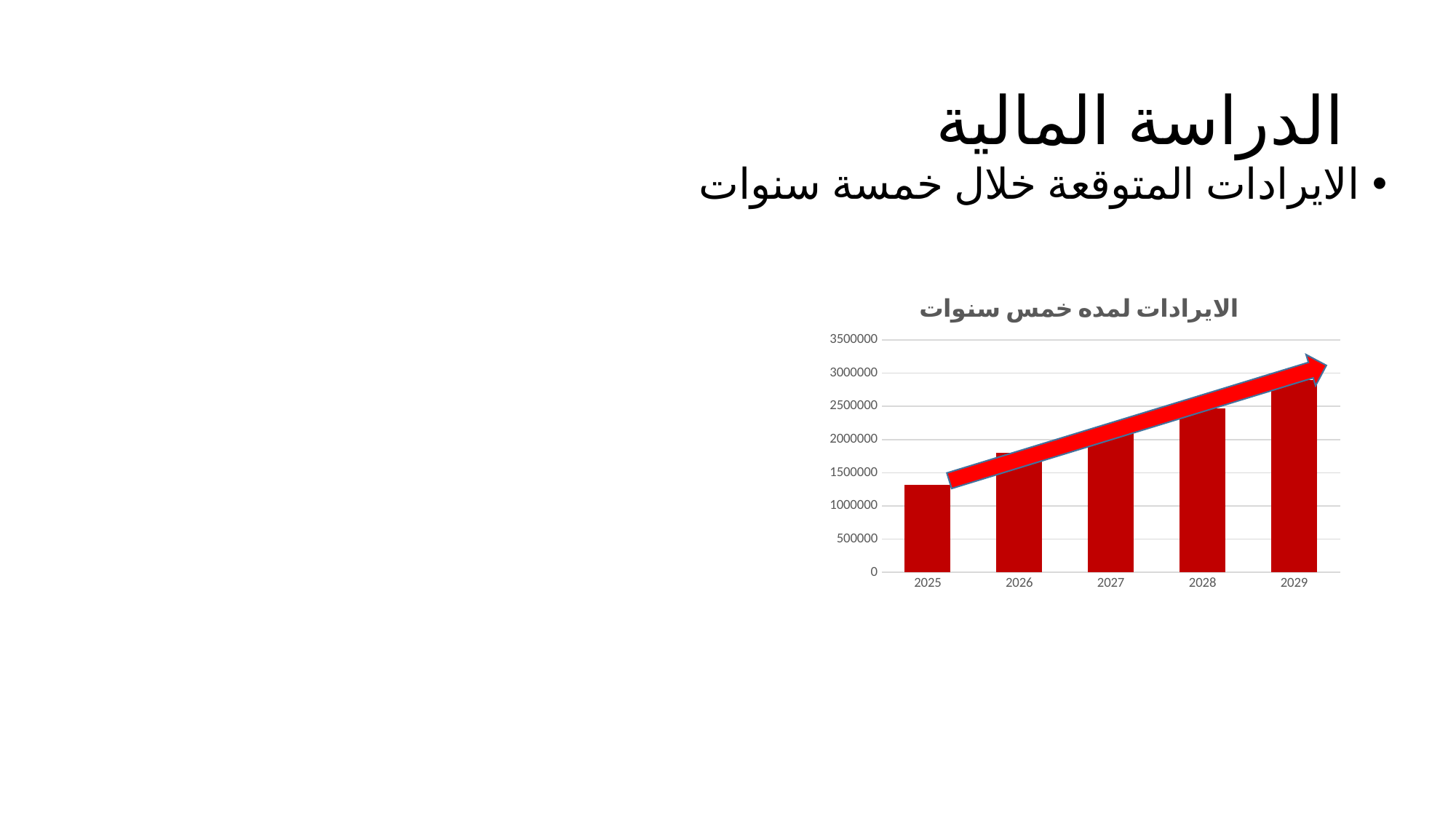
Is the value for 2025 greater or less than 1500000? less What colour are the bars in the chart? Red Is the value for 2029 greater or less than 2500000? greater Is the value for 2026 greater or less than 1500000? greater Do the values rise or fall from 2025 to 2029? Rise Which year has the lowest bar in the chart? 2025 What kind of chart is shown on the slide? Bar chart Which is larger, the value for 2027 or the value for 2029? 2029 What is the title of the chart? الايرادات لمده خمس سنوات How many years are shown on the x axis of the chart? 5 Which year has the highest bar in the chart? 2029